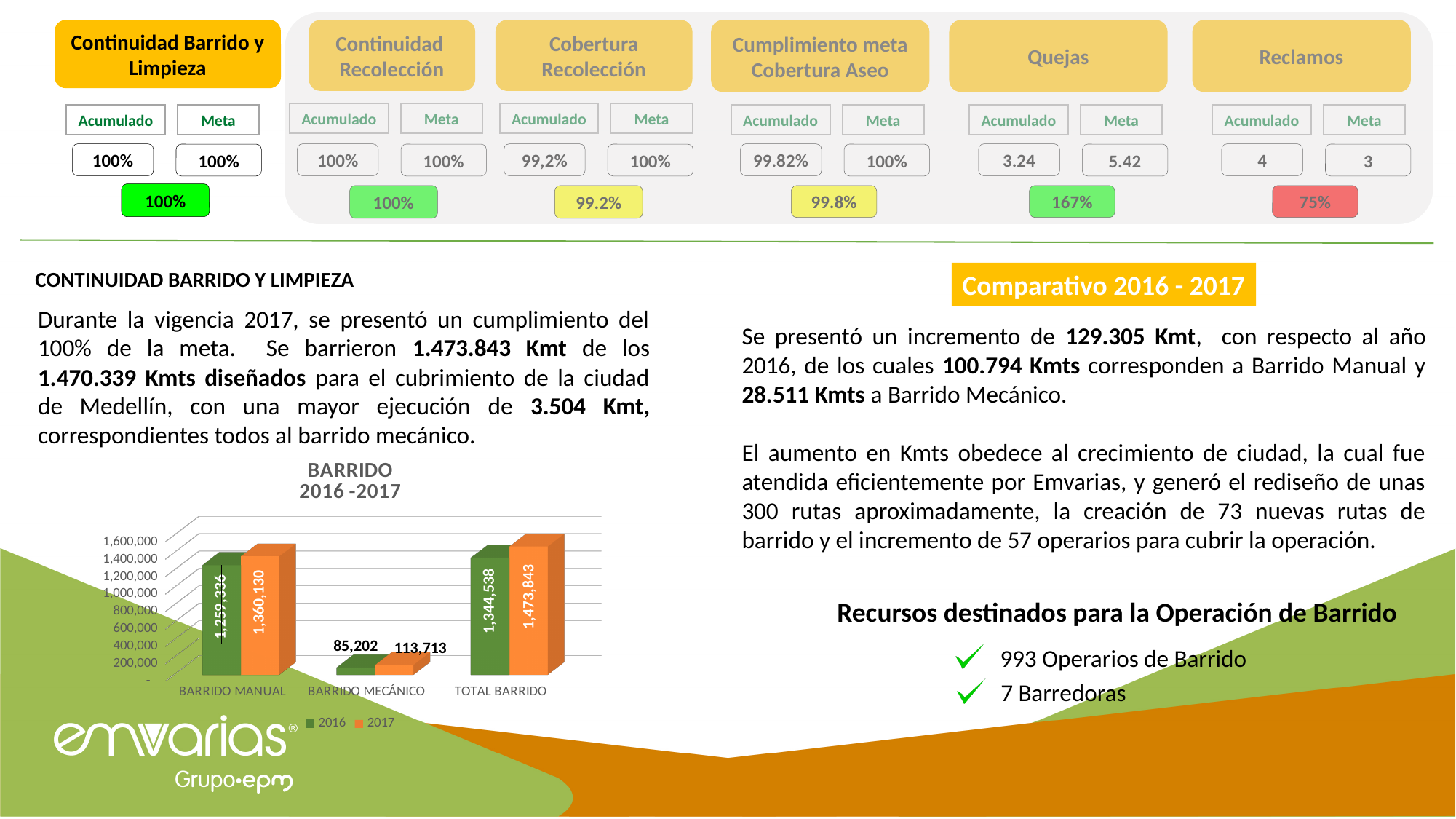
In the 'BARRIDO 2016 - 2017' chart, which category has the lowest values? BARRIDO MECÁNICO What type of chart is shown under the title 'BARRIDO 2016 - 2017'? bar chart In the 'BARRIDO 2016 - 2017' chart, what is the value for BARRIDO MECÁNICO in 2016? 85,202 In the 'BARRIDO 2016 - 2017' chart, which category has the highest value for 2017? TOTAL BARRIDO In the 'BARRIDO 2016 - 2017' chart, what is the value for TOTAL BARRIDO in 2017? 1,473,843 How many categories are shown on the x axis of the 'BARRIDO 2016 - 2017' chart? 3 How many series does the legend of the 'BARRIDO 2016 - 2017' chart list? 2 In the 'BARRIDO 2016 - 2017' chart, what is the difference between the 2017 and 2016 values for BARRIDO MECÁNICO? 28,511 In the 'BARRIDO 2016 - 2017' chart, is the 2017 value for BARRIDO MANUAL larger or smaller than the 2016 value? larger In the 'BARRIDO 2016 - 2017' chart, which colour represents the 2017 series? orange In the 'BARRIDO 2016 - 2017' chart, what is the value for BARRIDO MECÁNICO in 2017? 113,713 In the 'BARRIDO 2016 - 2017' chart, what is the value for BARRIDO MANUAL in 2016? 1,259,336